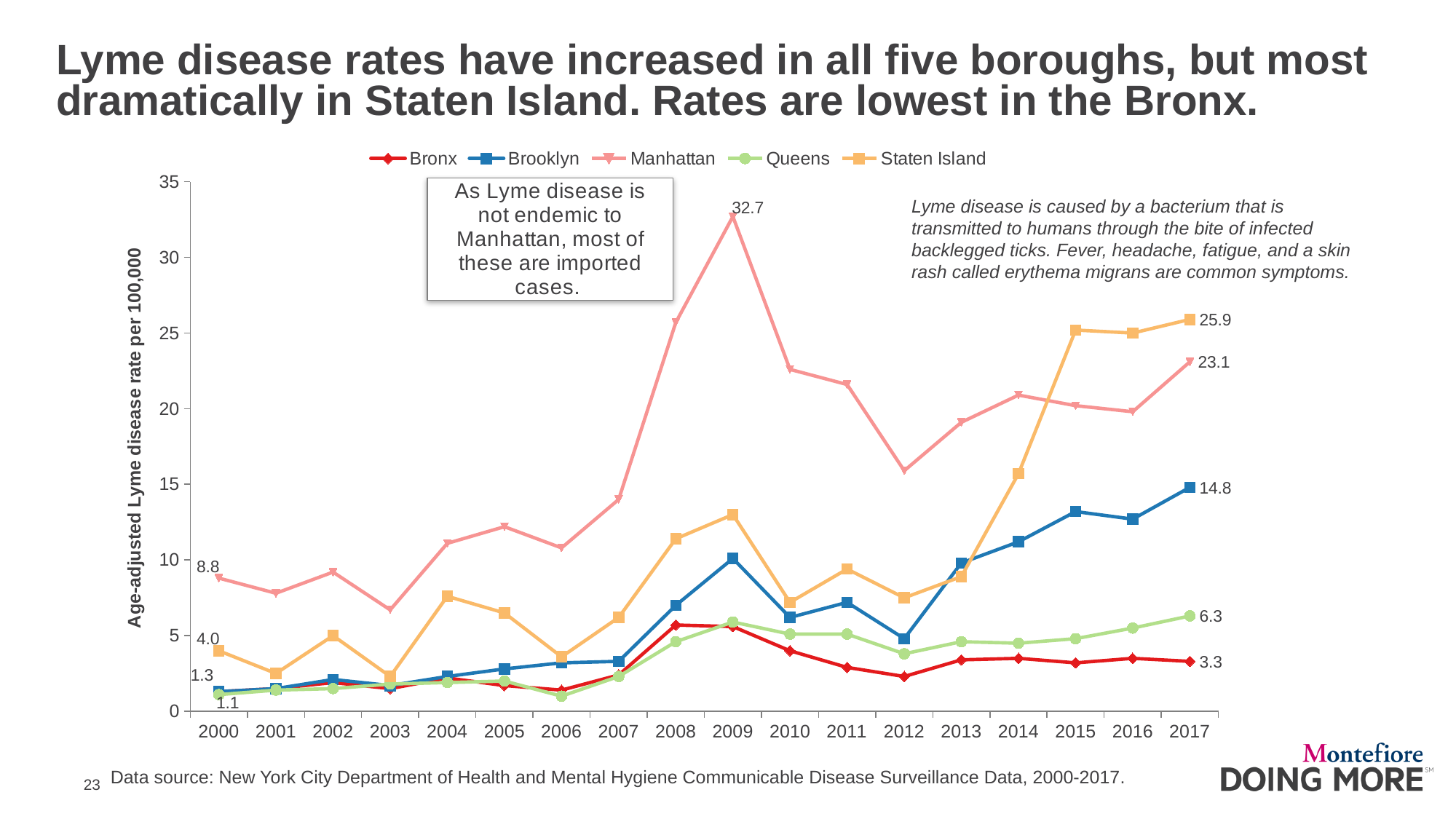
In 2017, which borough had the higher Lyme disease rate, Brooklyn or Queens? Brooklyn What was the Lyme disease rate in Brooklyn in 2017? 14.8 What was the Lyme disease rate in Staten Island in 2017? 25.9 Which borough had the lowest Lyme disease rate in 2017? Bronx What is the difference between the Staten Island and Manhattan Lyme disease rates in 2017? 2.8 Which borough had the highest Lyme disease rate in 2017? Staten Island What was the Lyme disease rate in Manhattan in 2009? 32.7 Is the Staten Island Lyme disease rate in 2009 greater or less than 10? greater By how much did Manhattan's Lyme disease rate increase from 2000 to 2017? 14.3 What was the Lyme disease rate in Manhattan in 2000? 8.8 What was the Lyme disease rate in Staten Island in 2000? 4.0 How many boroughs are listed in the chart legend? 5